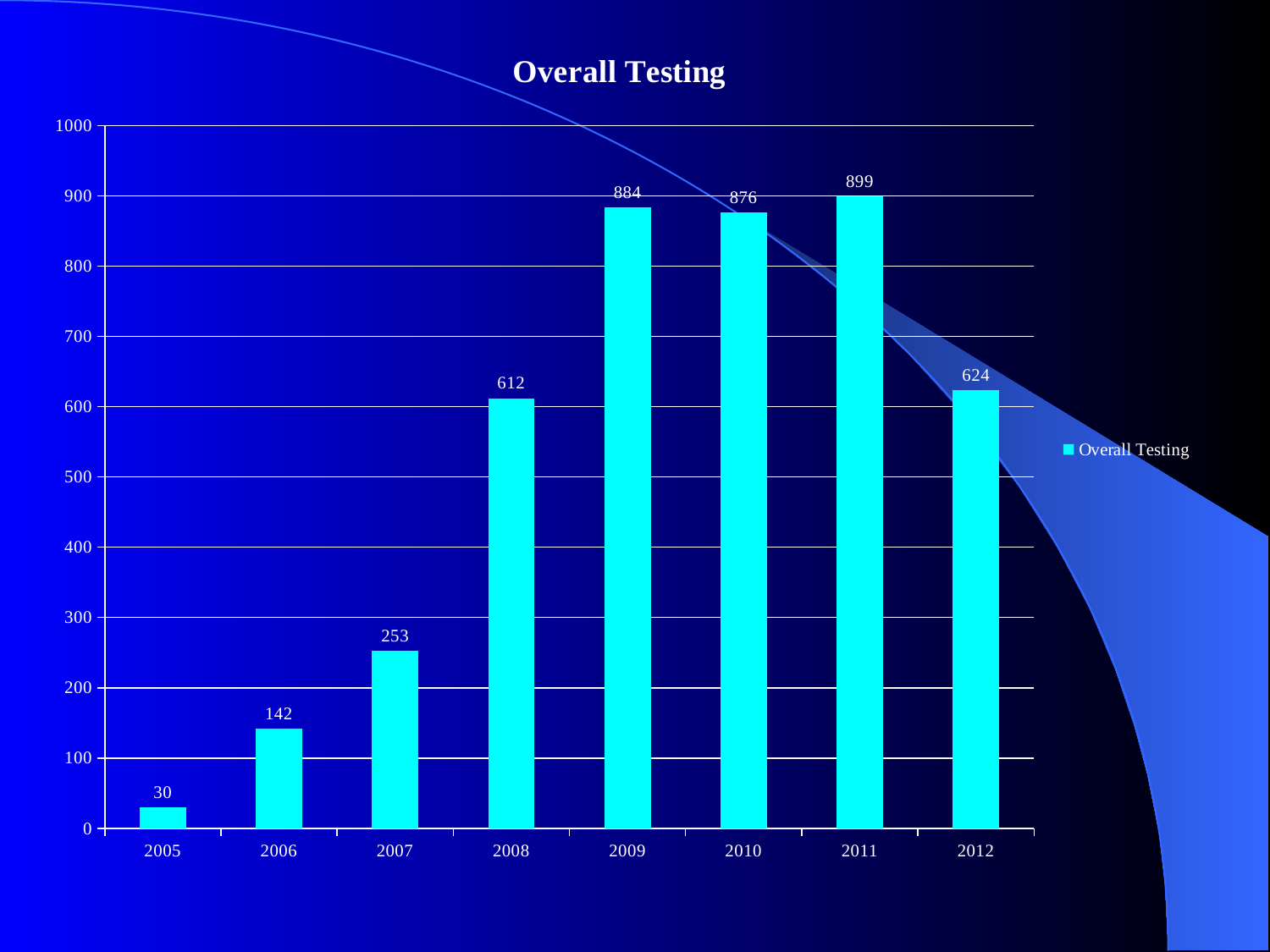
What is the value for 2012? 624 Is the value for 2007 greater or less than 300? less What is the value for 2008? 612 What kind of chart is this? bar chart What is the difference between the values for 2011 and 2010? 23 Which year has the lowest value? 2005 What is the difference between the values for 2008 and 2007? 359 How many years are shown on the x axis? 8 Which year has the highest value? 2011 What is the title of the chart? Overall Testing What is the value for 2005? 30 Which is larger, the value for 2009 or the value for 2012? 2009